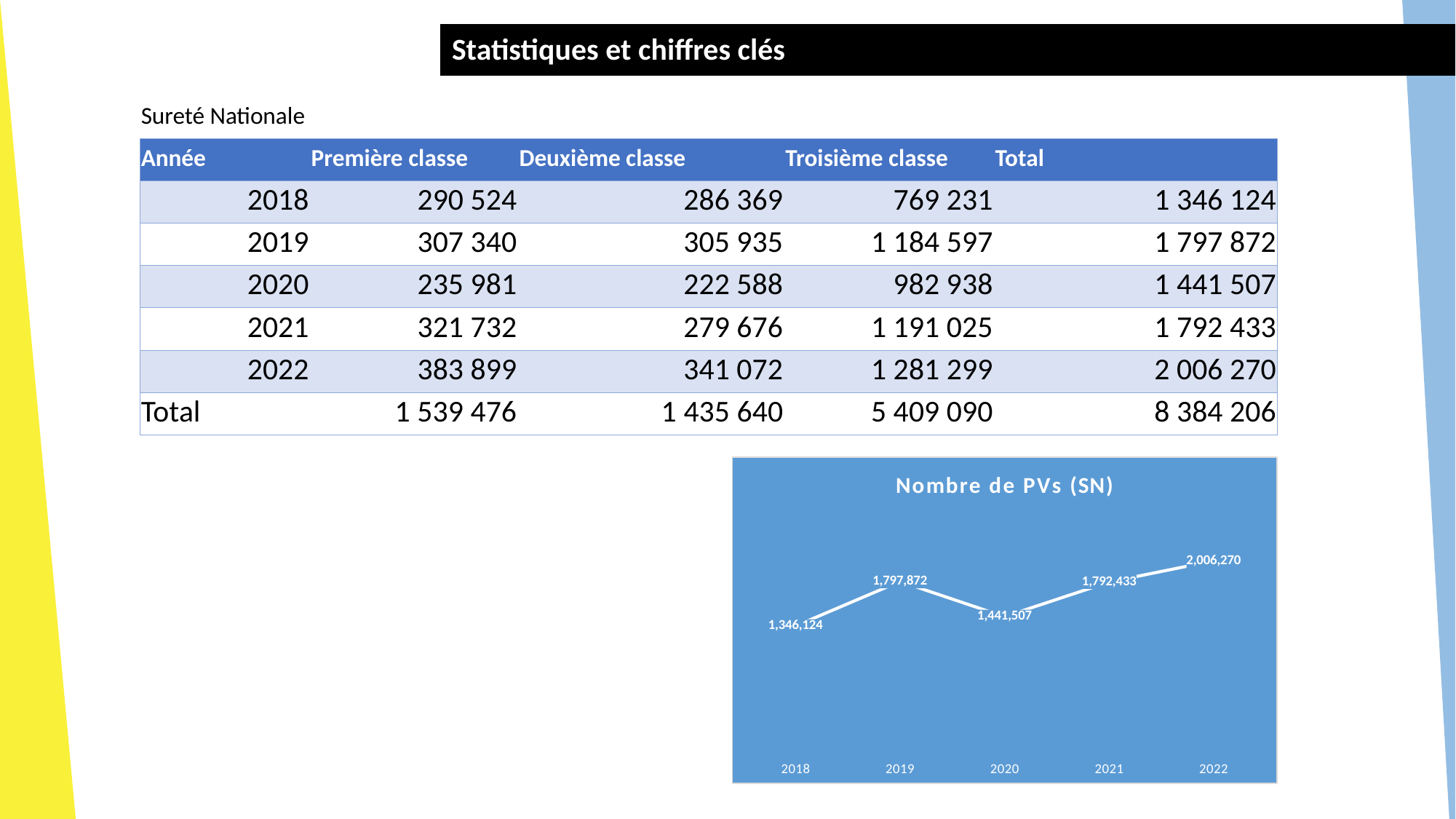
In the "Nombre de PVs (SN)" chart, does the value rise or fall from 2019 to 2020? fall In the "Nombre de PVs (SN)" chart, what is the difference between the 2019 value and the 2020 value? 356,365 What type of chart is shown under the title "Nombre de PVs (SN)"? line chart In the "Nombre de PVs (SN)" chart, what is the value for 2022? 2,006,270 In the "Nombre de PVs (SN)" chart, which is larger: the value for 2020 or the value for 2021? 2021 What is the title of the chart on the slide? Nombre de PVs (SN) In the "Nombre de PVs (SN)" chart, what is the difference between the 2022 value and the 2018 value? 660,146 In the "Nombre de PVs (SN)" chart, what is the value for 2018? 1,346,124 In the "Nombre de PVs (SN)" chart, what is the value for 2020? 1,441,507 In the "Nombre de PVs (SN)" chart, which year has the highest value? 2022 In the "Nombre de PVs (SN)" chart, which year has the lowest value? 2018 How many years are plotted in the "Nombre de PVs (SN)" chart? 5